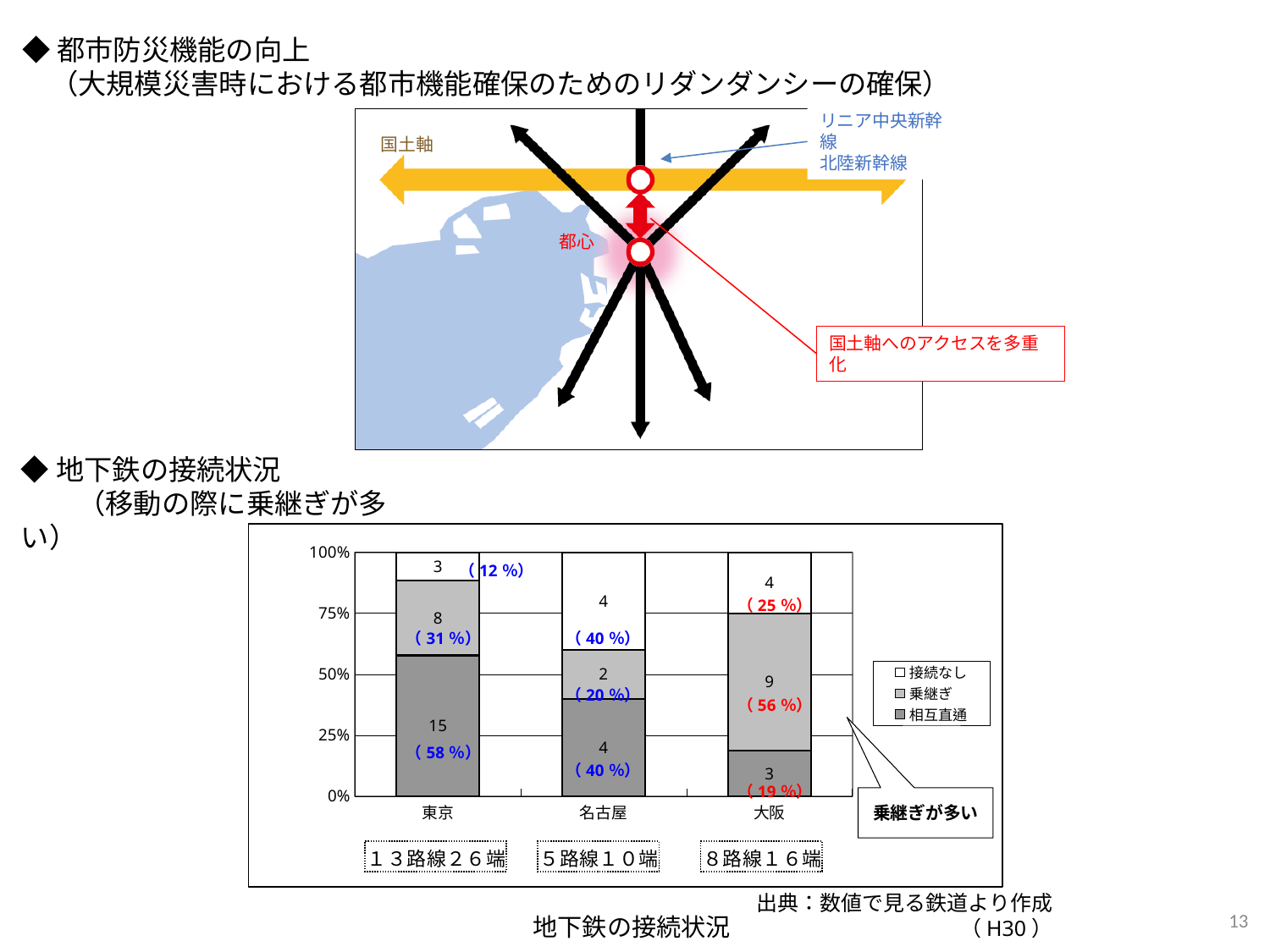
Which is larger, the 乗継ぎ value for 大阪 or the 乗継ぎ value for 東京? 大阪 Which city has the highest 相互直通 value? 東京 What is the 乗継ぎ value for 大阪? 9 What percentage is shown for 乗継ぎ in 東京? 31 % What is the 接続なし value for 名古屋? 4 What is the difference between the 相互直通 values for 東京 and 大阪? 12 What is the total of the three values in the 名古屋 bar? 10 Which city has the lowest 乗継ぎ value? 名古屋 How many categories are shown on the x axis of the chart? 3 What is the 相互直通 value for 東京? 15 What kind of chart is shown on the slide? stacked bar chart How many series does the chart's legend list? 3